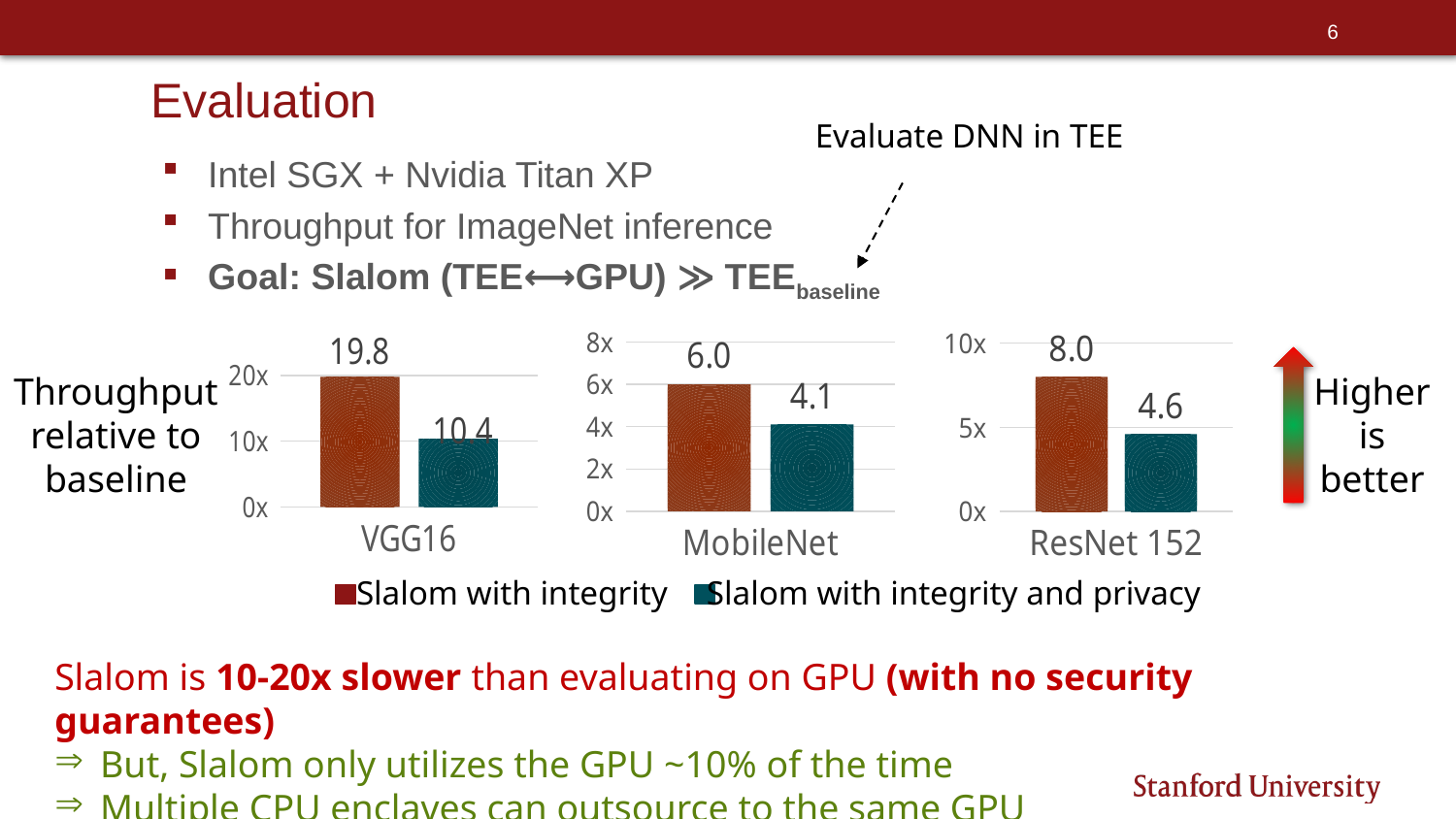
In the VGG16 chart, what is the value for Slalom with integrity and privacy? 10.4 In the ResNet 152 chart, what is the value for Slalom with integrity? 8.0 In the ResNet 152 chart, what is the value for Slalom with integrity and privacy? 4.6 What kind of chart is the ResNet 152 chart? bar chart In the MobileNet chart, what is the value for Slalom with integrity and privacy? 4.1 In the MobileNet chart, which bar is larger: Slalom with integrity or Slalom with integrity and privacy? Slalom with integrity In the VGG16 chart, is the value for Slalom with integrity and privacy greater or less than 20x? less In the ResNet 152 chart, what is the difference between the Slalom with integrity bar and the Slalom with integrity and privacy bar? 3.4 In the VGG16 chart, what is the value for Slalom with integrity? 19.8 In the MobileNet chart, what is the value for Slalom with integrity? 6.0 In the VGG16 chart, what is the difference between the Slalom with integrity bar and the Slalom with integrity and privacy bar? 9.4 How many series does the shared legend below the charts list? 2